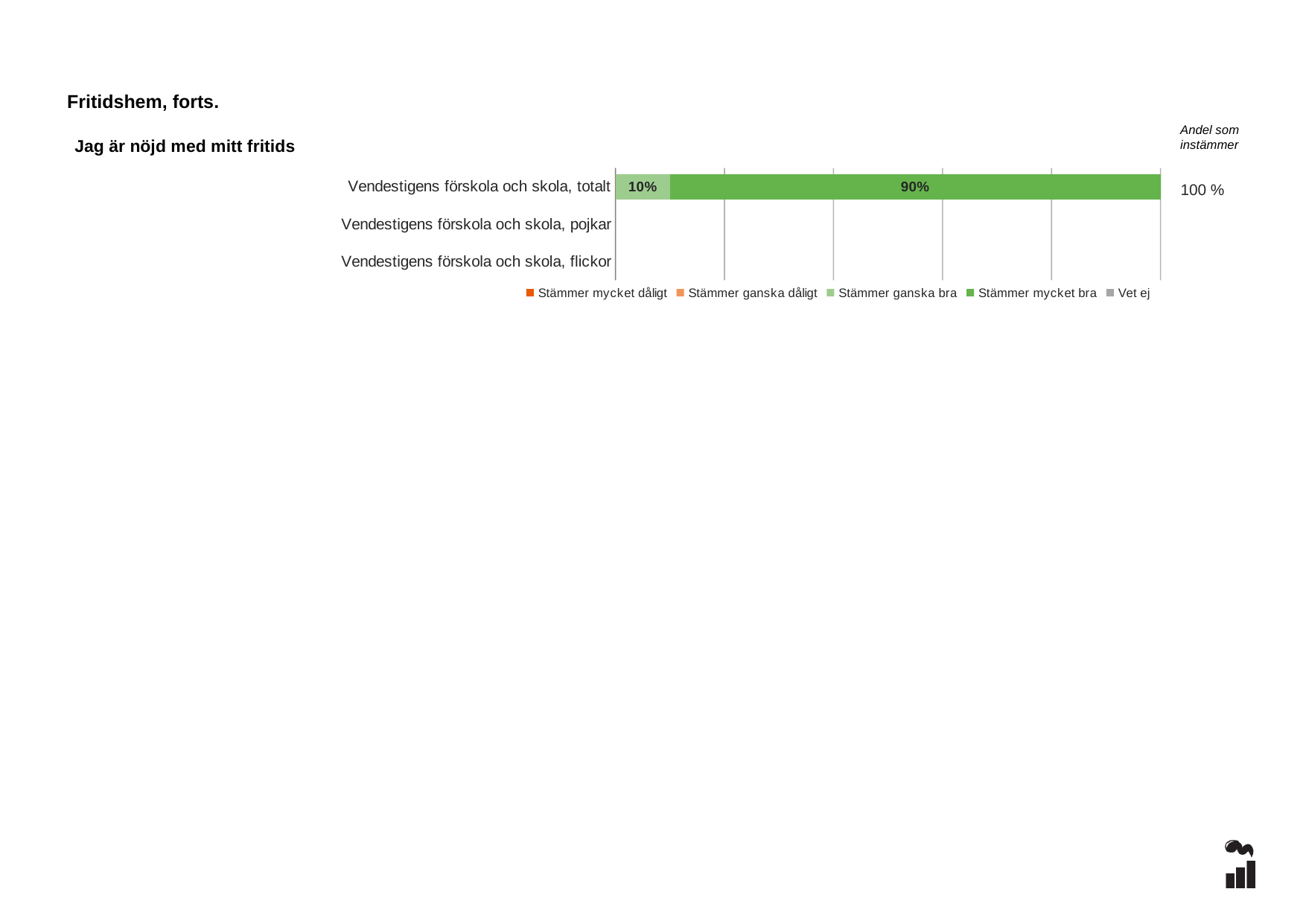
Which segment is larger in the 'Vendestigens förskola och skola, totalt' bar: 'Stämmer ganska bra' or 'Stämmer mycket bra'? Stämmer mycket bra How many series does the legend list? 5 What kind of chart is shown on the slide? Stacked bar chart What is the difference between the 'Stämmer mycket bra' and 'Stämmer ganska bra' segments for 'Vendestigens förskola och skola, totalt'? 80% What is the value of the 'Stämmer ganska bra' segment for 'Vendestigens förskola och skola, totalt'? 10% What is the total of the stacked bar for 'Vendestigens förskola och skola, totalt'? 100% What is the title of the chart? Jag är nöjd med mitt fritids What is the 'Andel som instämmer' value shown for 'Vendestigens förskola och skola, totalt'? 100 % Which legend entry is shown in dark green? Stämmer mycket bra What is the value of the 'Stämmer mycket bra' segment for 'Vendestigens förskola och skola, totalt'? 90% How many categories are listed on the vertical axis of the chart? 3